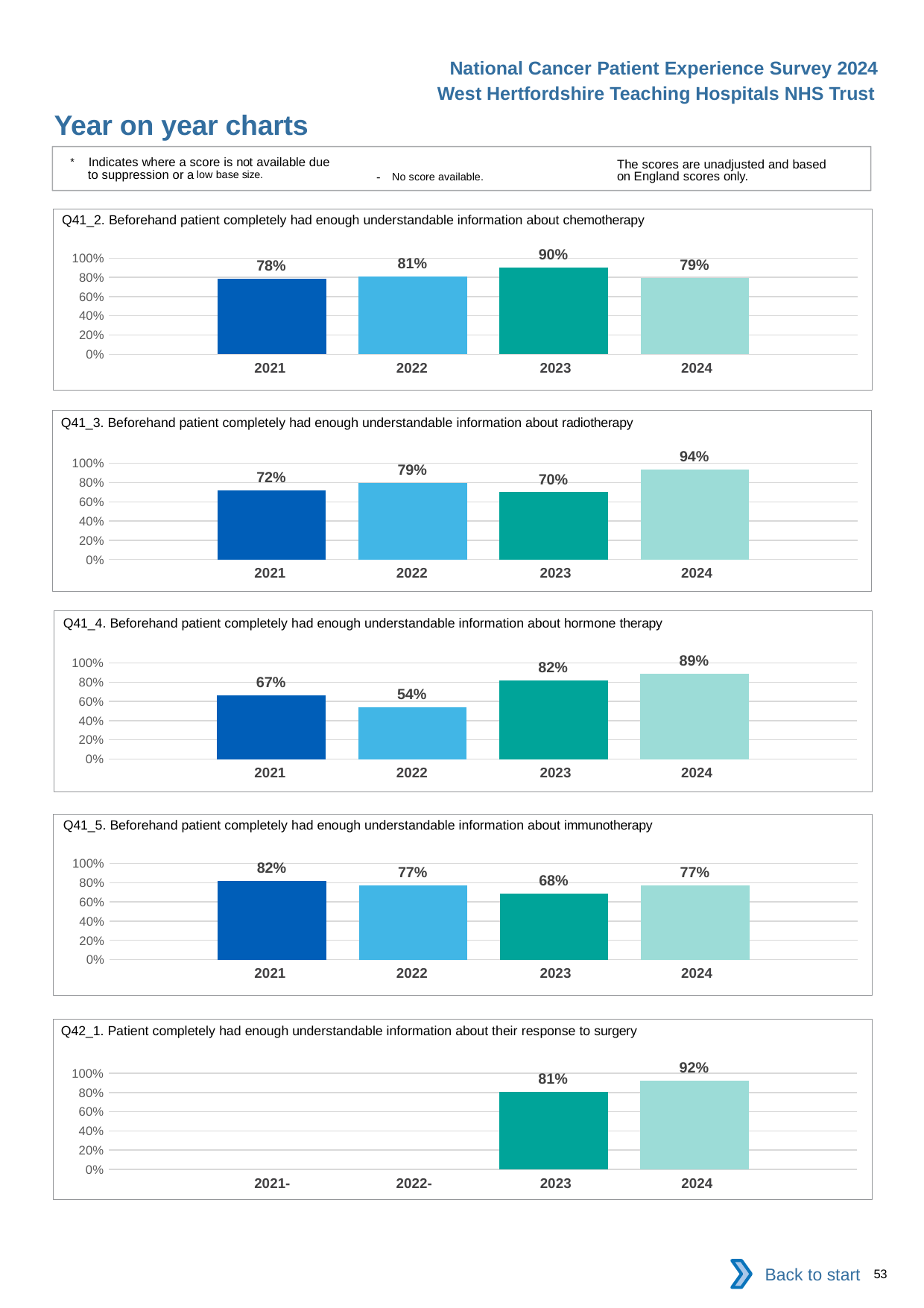
In the Q42_1 chart (response to surgery), what is the value for 2024? 92% In the Q41_4 chart (hormone therapy), which year has the lowest value? 2022 In the Q41_3 chart (radiotherapy), which year has the highest value? 2024 What kind of chart is the Q41_4 chart (hormone therapy)? Bar chart In the Q41_2 chart (chemotherapy), which is larger, the value for 2022 or the value for 2024? 2022 In the Q41_5 chart (immunotherapy), what is the difference between the 2021 and 2023 values? 14% How many bars are plotted in the Q42_1 chart (response to surgery)? 2 In the Q41_3 chart (radiotherapy), what is the difference between the 2024 and 2023 values? 24% In the Q41_4 chart (hormone therapy), do the values rise or fall from 2022 to 2024? Rise How many charts are shown on the slide? 5 In the Q41_5 chart (immunotherapy), what is the value for 2021? 82% In the Q41_2 chart (chemotherapy), what is the value for 2023? 90%